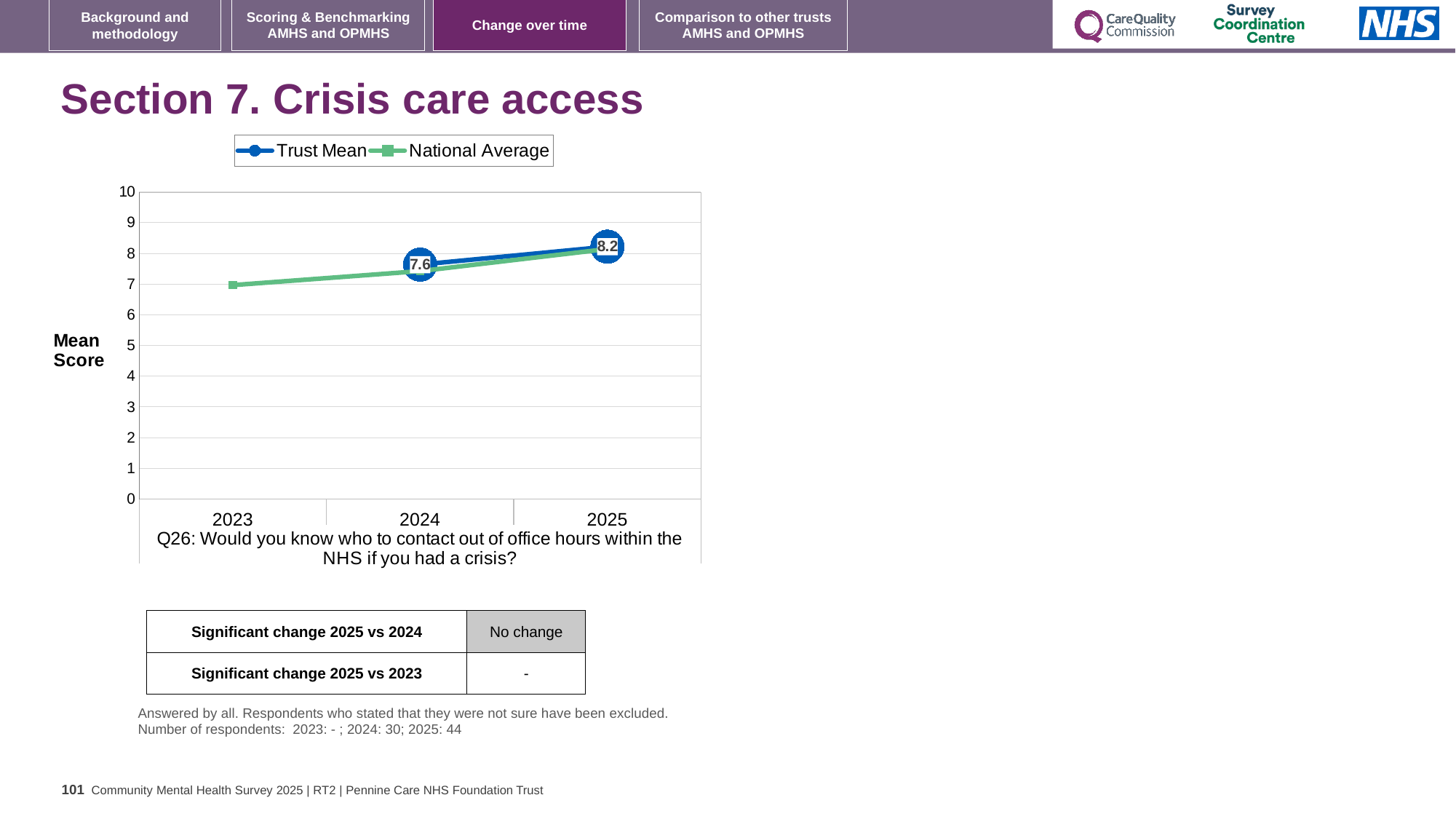
Which year has the higher Trust Mean score, 2024 or 2025? 2025 Does the Trust Mean score rise or fall from 2024 to 2025? rise What is the Trust Mean score for 2025? 8.2 Is the National Average value for 2023 greater or less than 8? less In which year is the Trust Mean score highest? 2025 What type of chart is shown on the slide? line chart What is the Trust Mean score for 2024? 7.6 What is the label on the y axis? Mean Score By how much did the Trust Mean score change from 2024 to 2025? 0.6 How many years are shown on the x axis? 3 How many series does the legend list? 2 What are the two series named in the legend? Trust Mean and National Average